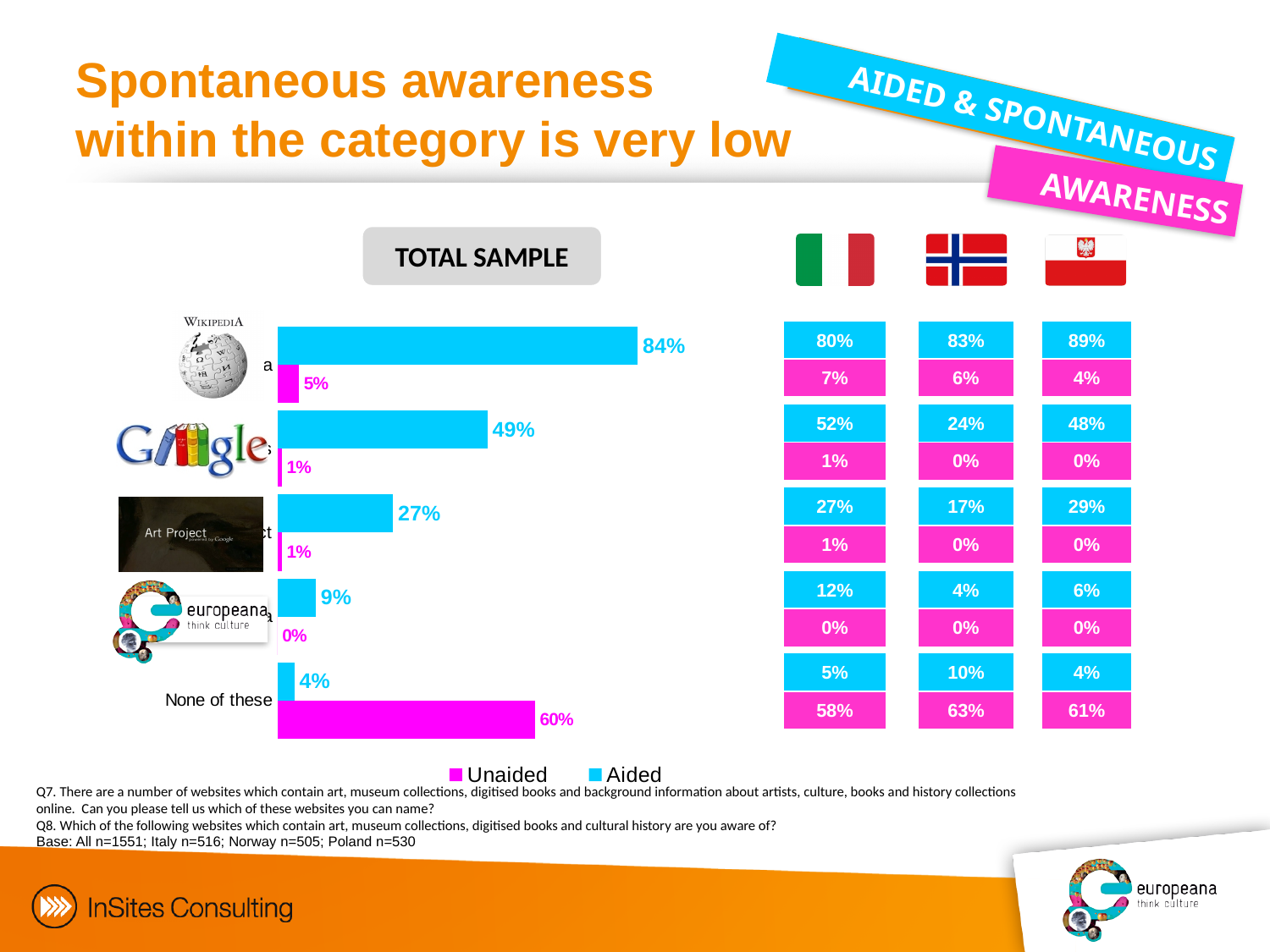
How many categories are shown in the Total Sample bar chart? 5 In the Total Sample chart, which is larger: the Aided value for Art Project or the Aided value for Europeana? Art Project What is the Aided value for Google in the Total Sample chart? 49% What is the Aided awareness value for Wikipedia in the Total Sample chart? 84% Which category has the lowest Aided value in the Total Sample chart? None of these What type of chart is used for the Total Sample data? Bar chart How many series does the legend of the Total Sample chart list? 2 What is the Unaided value for 'None of these' in the Total Sample chart? 60% Which colour represents the Aided series in the Total Sample chart? Cyan (light blue) What is the difference between the Aided values for Wikipedia and Google in the Total Sample chart? 35% Which category has the highest Aided value in the Total Sample chart? Wikipedia What is the Unaided awareness value for Wikipedia in the Total Sample chart? 5%